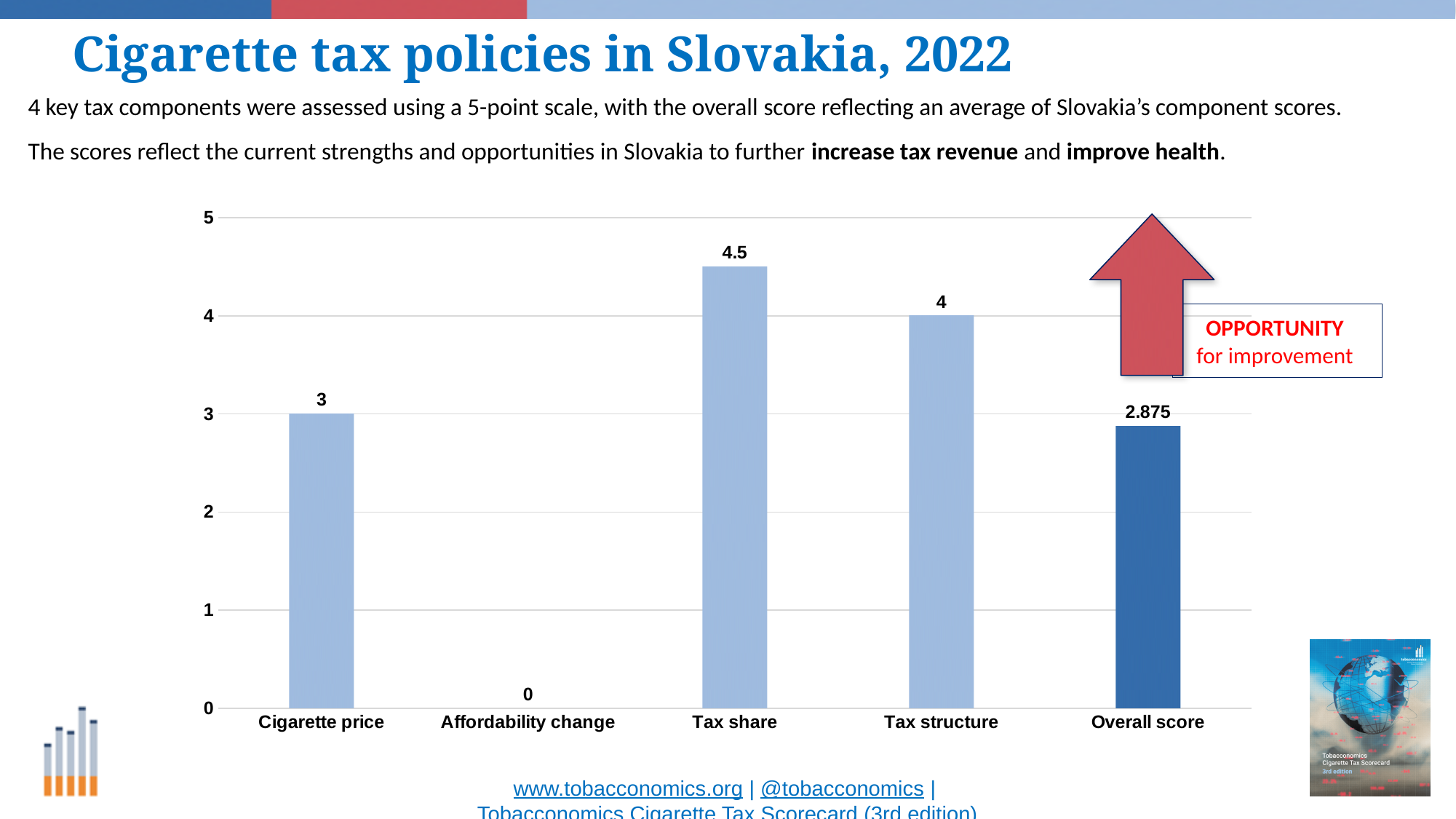
Which category has the highest value? Tax share Is the value for Overall score greater or less than 3? less What is the value for Overall score? 2.875 What is the value for Cigarette price? 3 What is the difference between the values for Cigarette price and Overall score? 0.125 Which category has the lowest value? Affordability change Which is larger, the value for Cigarette price or the value for Tax structure? Tax structure What is the value for Affordability change? 0 What is the difference between the values for Tax share and Tax structure? 0.5 How many categories are shown on the x axis? 5 What kind of chart is shown on the slide? Bar chart What is the value for Tax share? 4.5